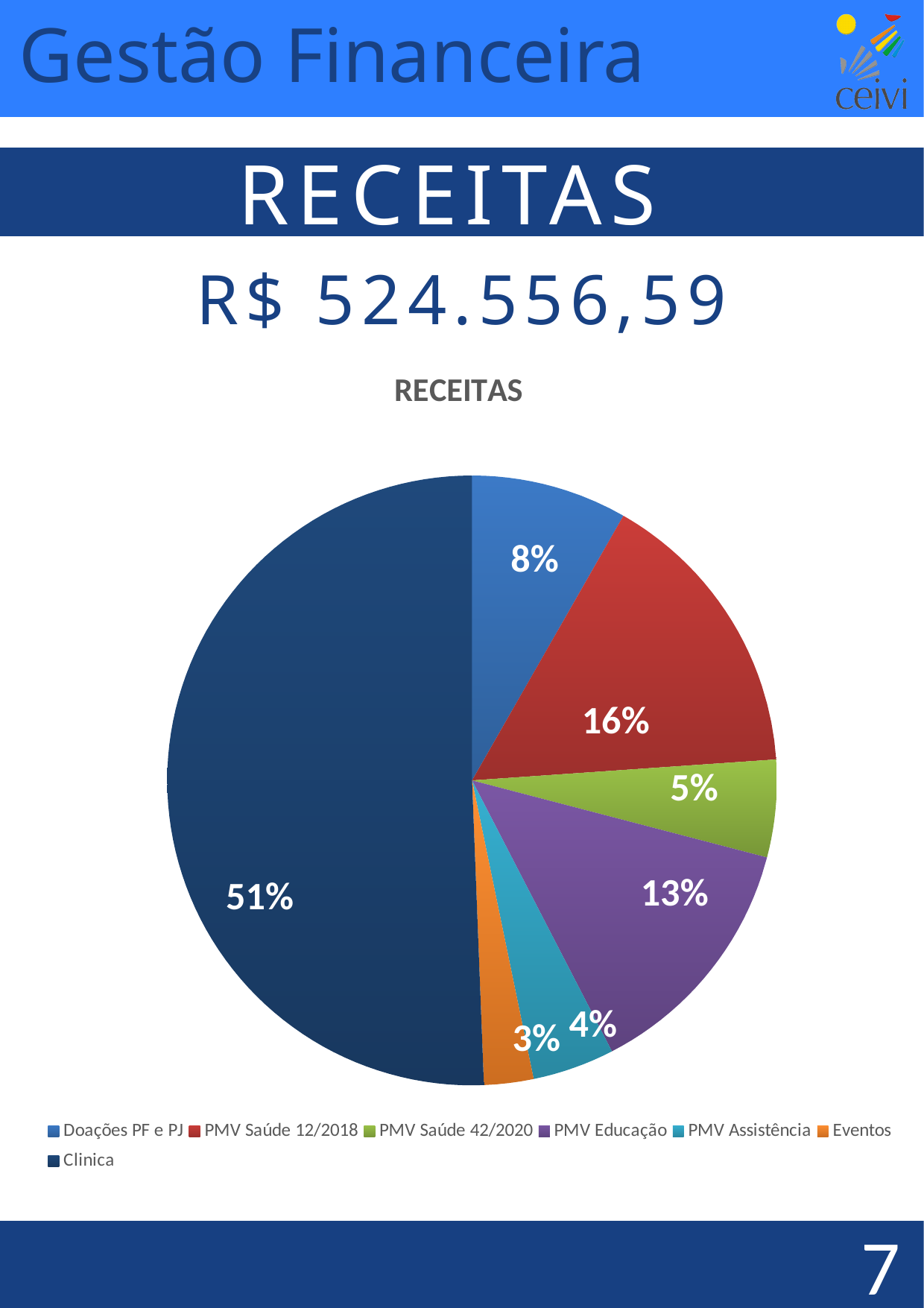
Which category has the largest slice of the pie? Clinica What is the title of the chart? RECEITAS What share of the pie does Doações PF e PJ represent? 8% What share of the pie does PMV Saúde 12/2018 represent? 16% What share of the pie does Clinica represent? 51% What is the difference in percentage points between PMV Saúde 12/2018 and PMV Saúde 42/2020? 11 percentage points Which category has the smallest slice of the pie? Eventos What type of chart is shown on the slide? Pie chart Which is larger, the share for PMV Educação or the share for PMV Assistência? PMV Educação How many categories does the legend list? 7